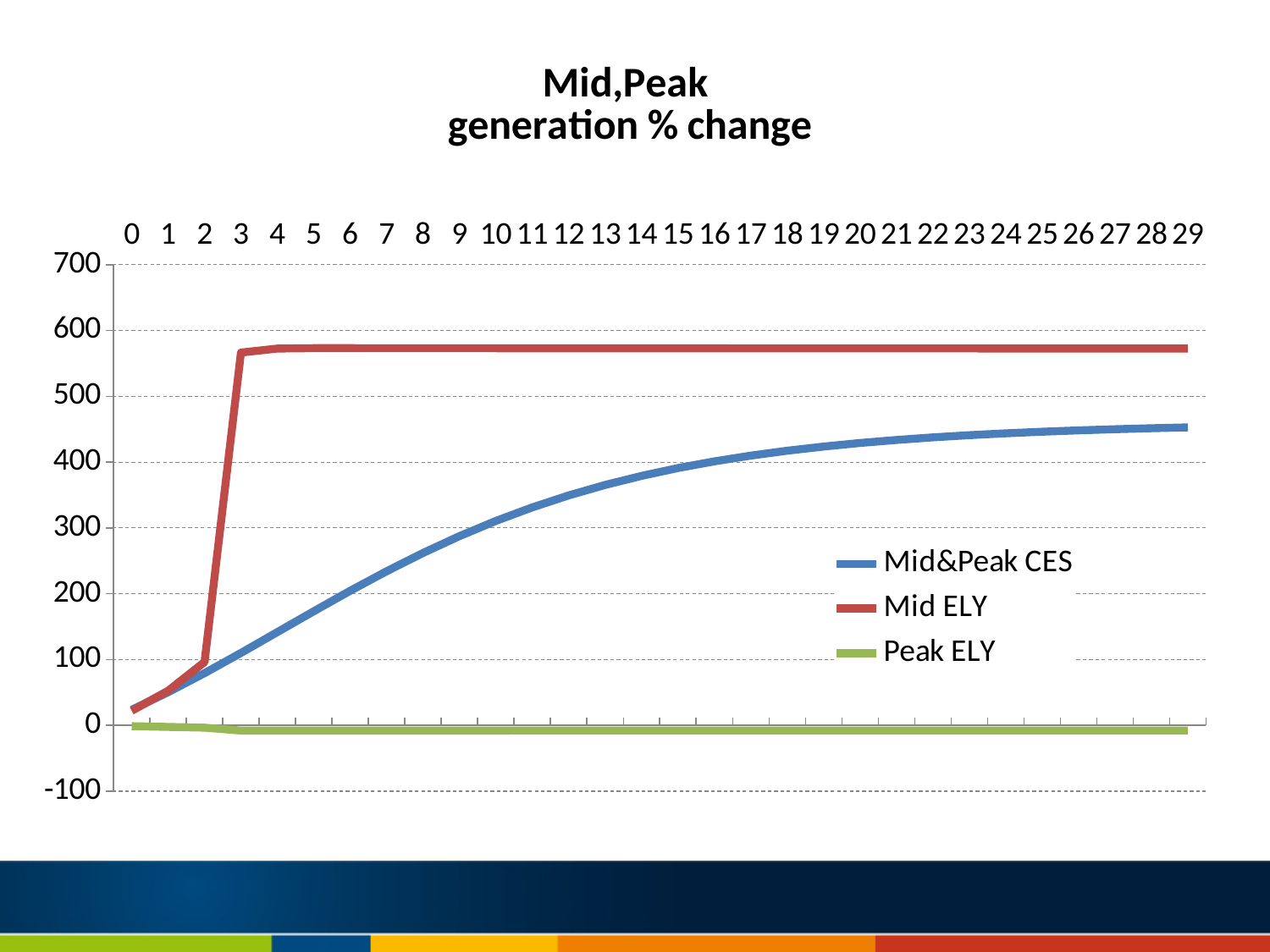
How many series does the legend list? 3 Is the value for Mid&Peak CES at x = 29 greater or less than 500? less Which is larger at x = 20, Mid ELY or Mid&Peak CES? Mid ELY Which series has the lowest value at x = 29? Peak ELY Is the value for Mid ELY at x = 10 greater or less than 500? greater What kind of chart is shown on the slide? line chart What is the title of the chart? Mid,Peak generation % change Which series has the highest value at x = 29? Mid ELY How many points are on the x axis of the chart? 30 Which colour is used for the Peak ELY series? green Is the value for Mid&Peak CES at x = 5 greater or less than 200? less Does the Mid&Peak CES series rise or fall from x = 0 to x = 29? rise